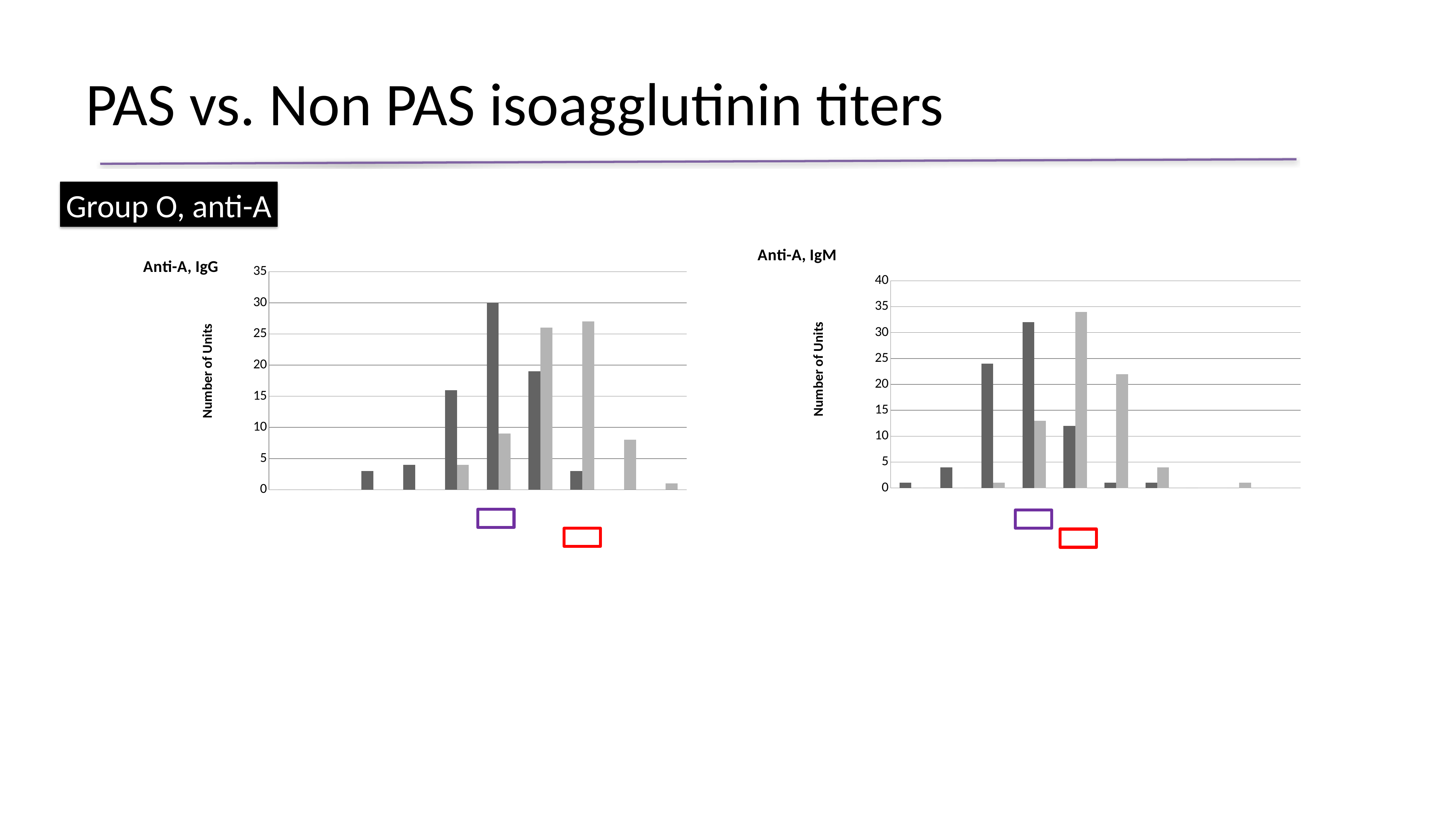
In the Anti-A, IgG chart, is the tallest bar greater or less than 35? less What kind of chart is the Anti-A, IgM chart? bar chart What kind of chart is the Anti-A, IgG chart? bar chart What is the y-axis title of the Anti-A, IgG chart? Number of Units Which chart has the higher top y-axis value, Anti-A, IgG or Anti-A, IgM? Anti-A, IgM What is the highest value shown on the y axis of the Anti-A, IgM chart? 40 In the Anti-A, IgM chart, is the tallest bar greater or less than 30? greater In the Anti-A, IgG chart, what value does the tallest bar reach? 30